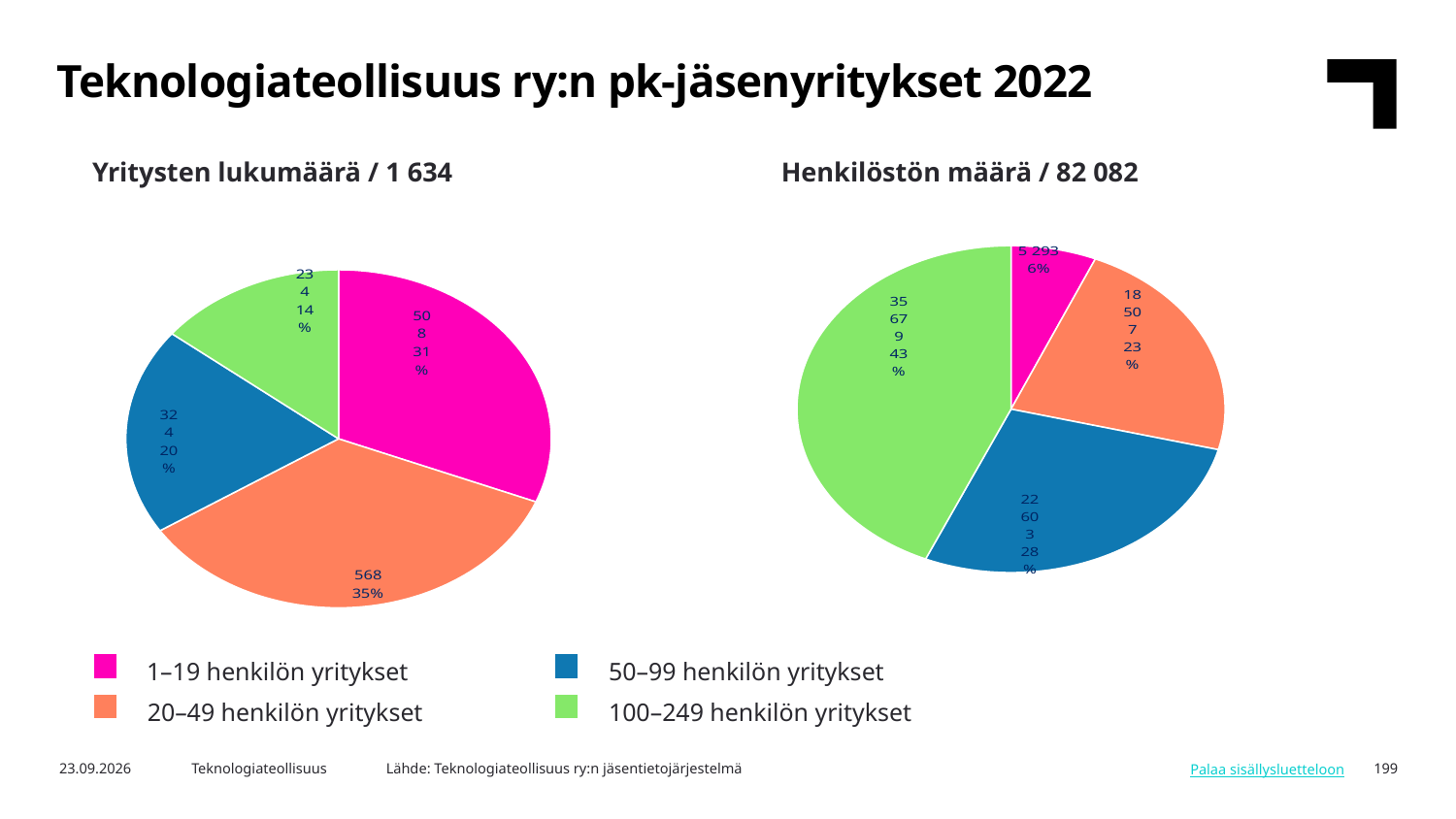
How many categories does the legend list for the pie charts? 4 In the 'Yritysten lukumäärä / 1 634' chart, what share of the pie is 20–49 henkilön yritykset? 35% In the 'Henkilöstön määrä / 82 082' chart, which category has the smallest slice? 1–19 henkilön yritykset What kind of chart is used on this slide for 'Yritysten lukumäärä / 1 634'? pie chart In the 'Yritysten lukumäärä / 1 634' chart, what is the value for 20–49 henkilön yritykset? 568 In the 'Henkilöstön määrä / 82 082' chart, which is larger: the slice for 50–99 henkilön yritykset or the slice for 20–49 henkilön yritykset? 50–99 henkilön yritykset In the 'Henkilöstön määrä / 82 082' chart, what share of the pie is 100–249 henkilön yritykset? 43% In the 'Henkilöstön määrä / 82 082' chart, which category has the largest slice? 100–249 henkilön yritykset In the 'Yritysten lukumäärä / 1 634' chart, which category has the smallest slice? 100–249 henkilön yritykset In the 'Yritysten lukumäärä / 1 634' chart, which category has the largest slice? 20–49 henkilön yritykset In the 'Henkilöstön määrä / 82 082' chart, what is the value for 1–19 henkilön yritykset? 5 293 In the 'Yritysten lukumäärä / 1 634' chart, what share of the pie is 1–19 henkilön yritykset? 31%